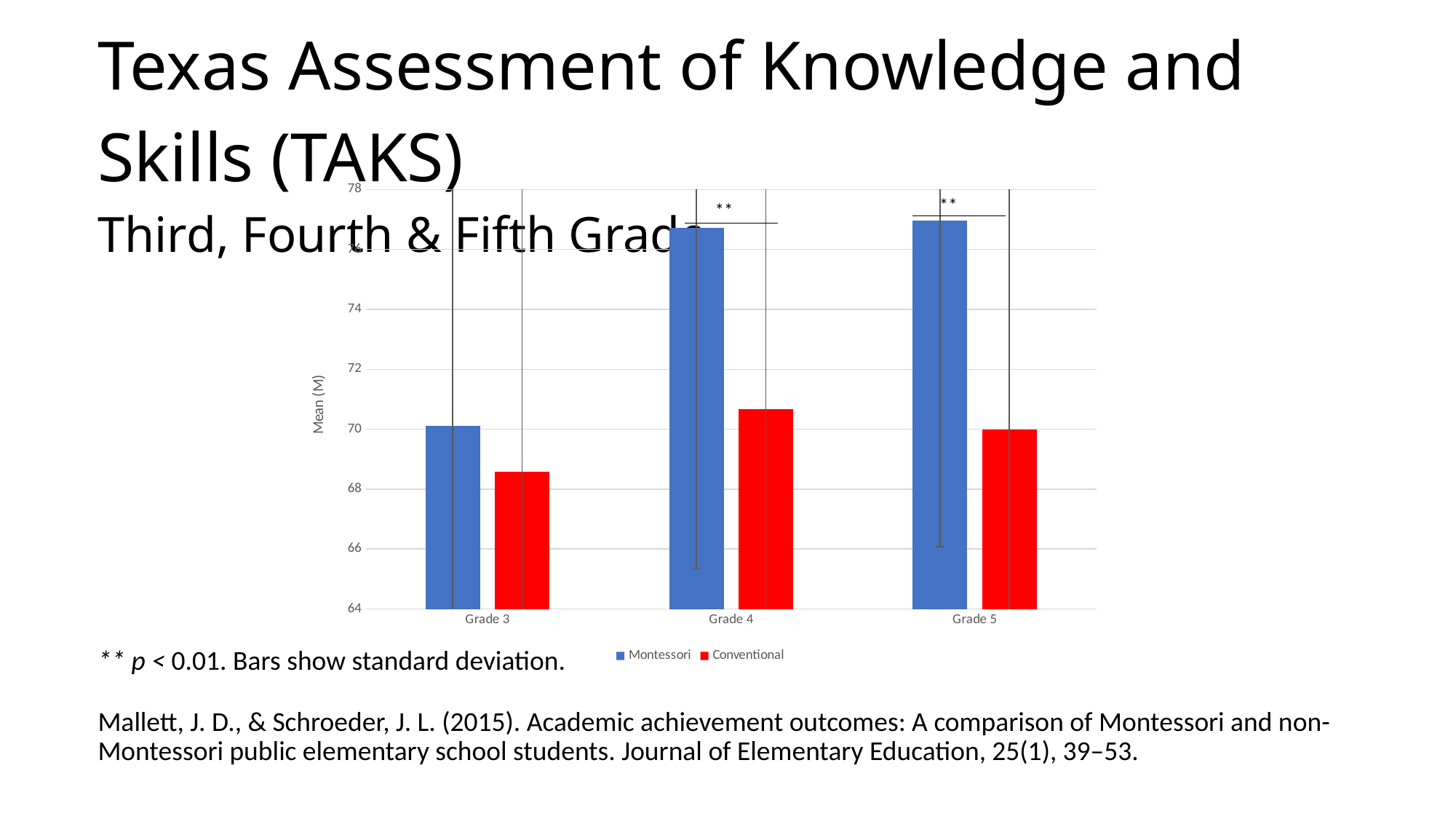
Is the Montessori value for Grade 4 greater or less than 76? greater How many grade categories are shown on the x axis of the chart? 3 Which grade has the lowest Conventional value? Grade 3 Is the Montessori value for Grade 5 greater or less than 76? greater Is the Conventional value for Grade 3 greater or less than 70? less What is the label on the chart's y axis? Mean (M) For Grade 4, which is larger, the Montessori value or the Conventional value? Montessori What kind of chart is shown on the slide? Bar chart How many series does the chart's legend list? 2 Which two series are listed in the chart's legend? Montessori and Conventional Which grade has the lowest Montessori value? Grade 3